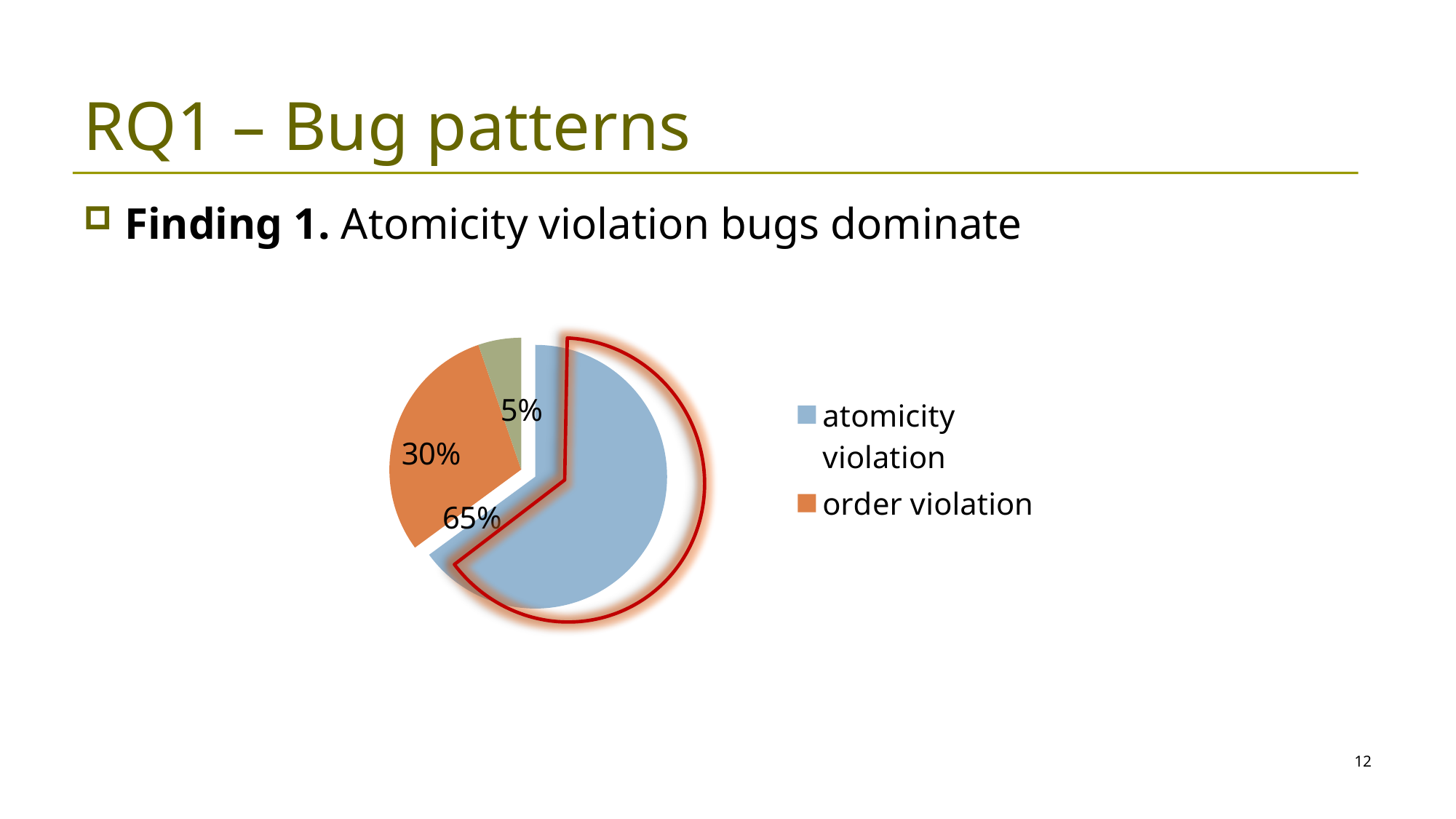
Which slice of the pie is outlined in red and pulled out from the rest? atomicity violation What kind of chart is shown on the slide? pie chart What colour is the atomicity violation slice in the pie chart? blue How many entries does the legend list? 2 What share of the pie does order violation account for? 30% Which is larger, the atomicity violation slice or the order violation slice? atomicity violation How many slices does the pie chart have? 3 What is the difference in percentage points between the atomicity violation slice and the order violation slice? 35 What share of the pie does atomicity violation account for? 65% What is the percentage shown on the smallest slice of the pie? 5% Is the share for order violation greater or less than 50%? less Which category has the largest slice of the pie? atomicity violation